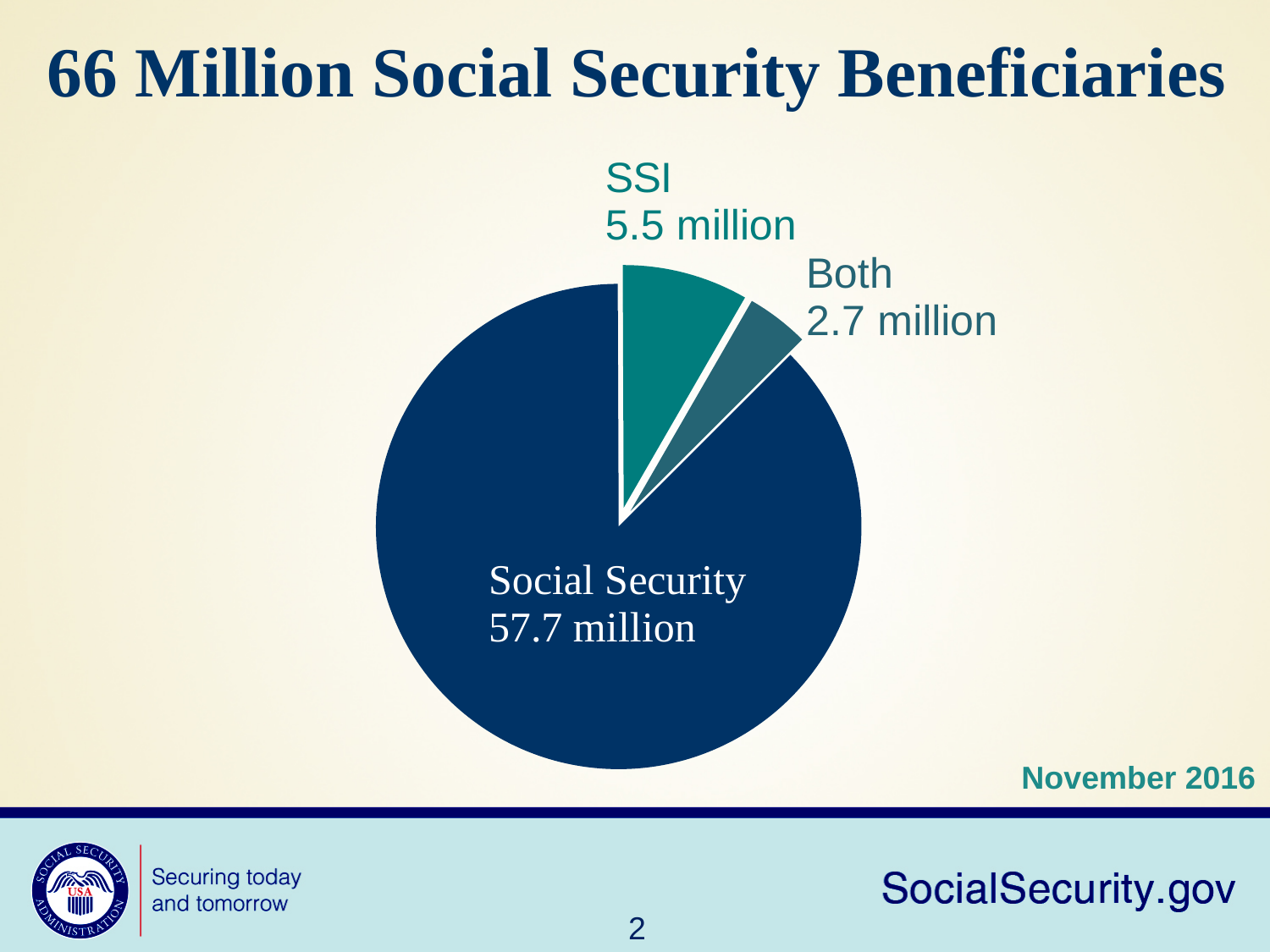
What value is shown for the SSI slice? 5.5 million How many beneficiaries are shown for the Social Security slice of the pie chart? 57.7 million What is the sum of the three slice values shown on the pie chart? 65.9 million What is the difference between the Social Security value and the SSI value? 52.2 million What is the title of the slide containing the pie chart? 66 Million Social Security Beneficiaries Which is larger, the SSI slice or the Both slice? SSI Which slice of the pie chart is the largest? Social Security How many slices does the pie chart have? 3 What kind of chart is shown on the slide? Pie chart How much larger is the SSI value than the Both value? 2.8 million Which slice of the pie chart is the smallest? Both What value is shown for the Both slice? 2.7 million